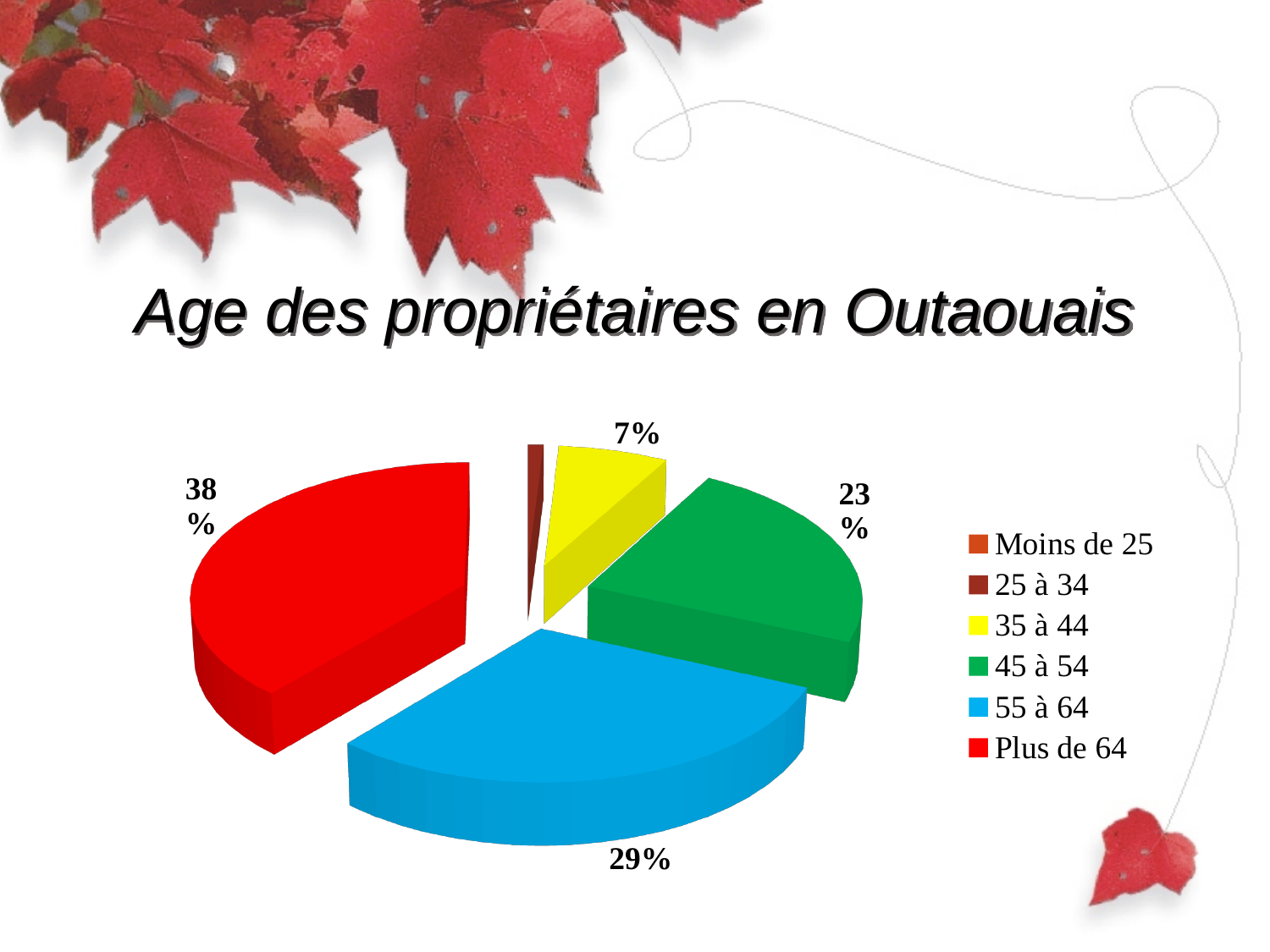
What share of the pie does the 'Plus de 64' category represent? 38% What percentage is shown for the '55 à 64' age group? 29% What percentage is shown for the '35 à 44' age group? 7% By how many percentage points does the 'Plus de 64' share exceed the '55 à 64' share? 9 How many age categories does the legend list? 6 Which is larger, the share for '55 à 64' or the share for '45 à 54'? 55 à 64 What percentage is shown for the '45 à 54' age group? 23% What is the title of the chart? Age des propriétaires en Outaouais What is the difference in percentage points between the '45 à 54' share and the '35 à 44' share? 16 What kind of chart is shown on the slide? Pie chart Which age group has the largest share of the pie? Plus de 64 What colour represents the 'Plus de 64' category in the pie chart? Red